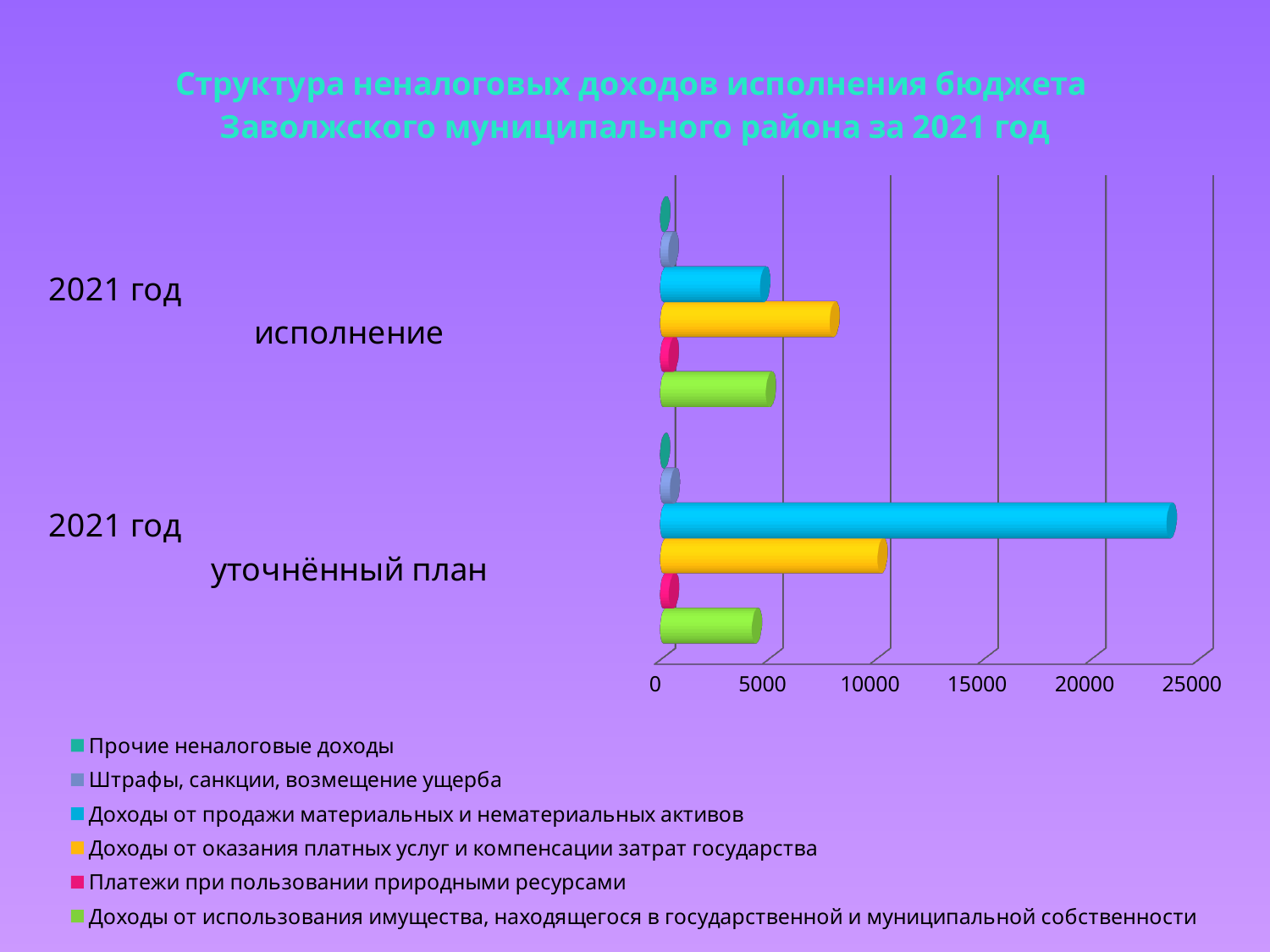
What colour represents 'Платежи при пользовании природными ресурсами' in the legend? red (pink) What kind of chart is shown on the slide? bar chart What is the title of the chart? Структура неналоговых доходов исполнения бюджета Заволжского муниципального района за 2021 год Is the value for 'Доходы от продажи материальных и нематериальных активов' in '2021 год уточнённый план' greater or less than 20000? greater Which series has the shortest bar in the '2021 год исполнение' category? Прочие неналоговые доходы How many categories are shown on the vertical axis of the chart? 2 How many series does the legend list? 6 Which series has the longest bar in the whole chart? Доходы от продажи материальных и нематериальных активов (2021 год уточнённый план) Which is larger for 'Доходы от продажи материальных и нематериальных активов': the '2021 год исполнение' value or the '2021 год уточнённый план' value? 2021 год уточнённый план In the '2021 год исполнение' category, which is larger: 'Доходы от оказания платных услуг и компенсации затрат государства' or 'Доходы от продажи материальных и нематериальных активов'? Доходы от оказания платных услуг и компенсации затрат государства Is the value for 'Штрафы, санкции, возмещение ущерба' in '2021 год уточнённый план' greater or less than 5000? less Is the value for 'Доходы от оказания платных услуг и компенсации затрат государства' in '2021 год исполнение' greater or less than 5000? greater